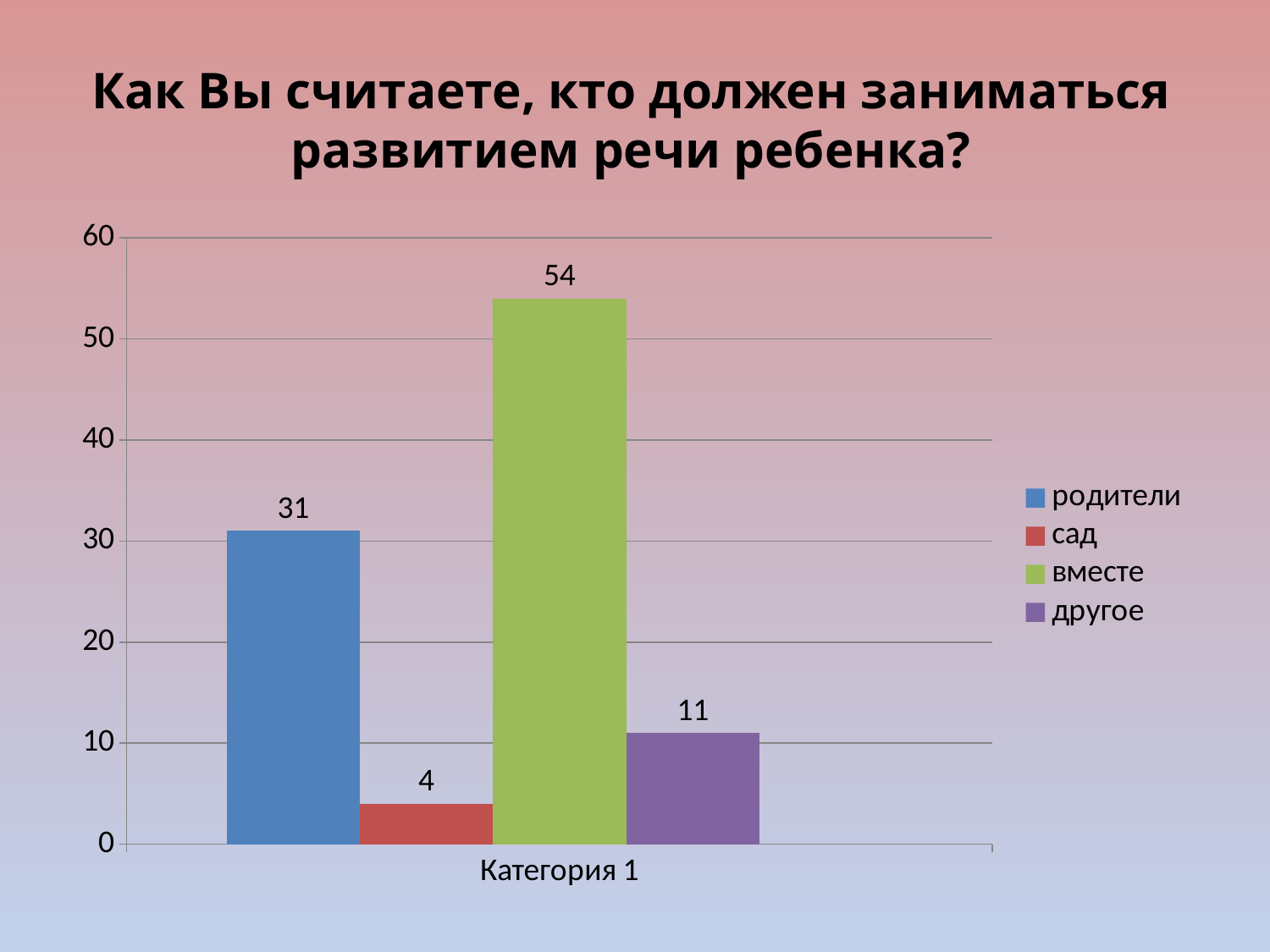
What is the difference between the values for вместе and родители? 23 Which series has the highest value? вместе How many series does the legend list? 4 What kind of chart is shown on the slide? bar chart What is the value for сад? 4 What colour is the bar for вместе? green Is the value for вместе greater or less than 50? greater Which is larger, the value for родители or the value for другое? родители What is the value for родители? 31 What is the value for другое? 11 Which series has the lowest value? сад What is the value for вместе? 54